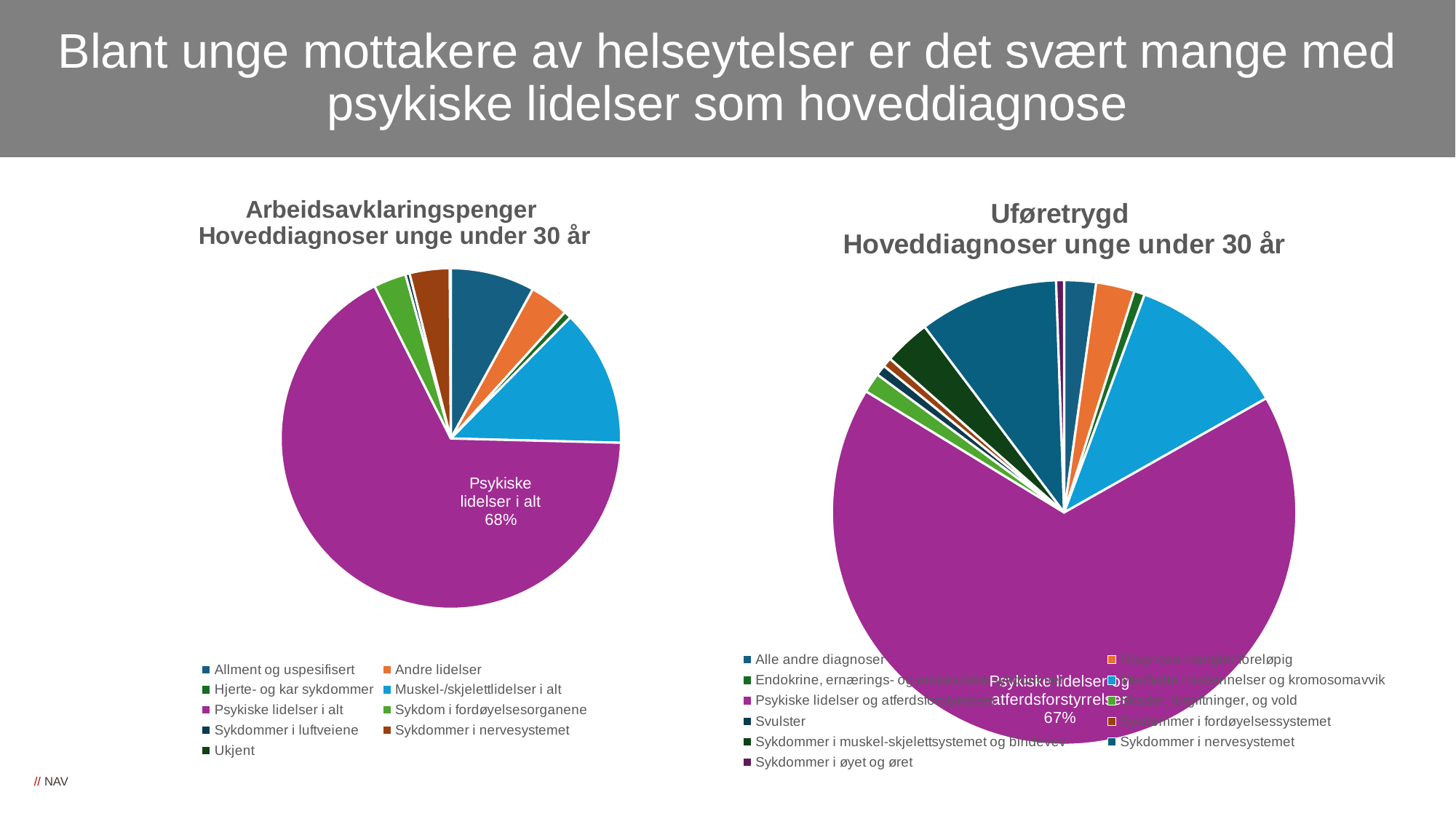
How many categories does the legend of the right chart (Uføretrygd) list? 11 In the left chart (Arbeidsavklaringspenger), which category has the largest slice? Psykiske lidelser i alt In the left chart (Arbeidsavklaringspenger), which category is shown in light blue? Muskel-/skjelettlidelser i alt What kind of chart is the left chart (Arbeidsavklaringspenger)? Pie chart In the left chart (Arbeidsavklaringspenger), what share of the pie is labelled for Psykiske lidelser i alt? 68% How many categories does the legend of the left chart (Arbeidsavklaringspenger) list? 9 What is the title of the right chart? Uføretrygd Hoveddiagnoser unge under 30 år What is the difference in percentage points between the psychiatric-disorder share in the Arbeidsavklaringspenger chart (68%) and in the Uføretrygd chart (67%)? 1 percentage point What kind of chart is the right chart (Uføretrygd)? Pie chart Which is larger: the share for psychiatric disorders in the Arbeidsavklaringspenger chart or in the Uføretrygd chart? Arbeidsavklaringspenger (68%) In the right chart (Uføretrygd), what share of the pie is labelled for Psykiske lidelser og atferdsforstyrrelser? 67% In the right chart (Uføretrygd), which category has the largest slice? Psykiske lidelser og atferdsforstyrrelser